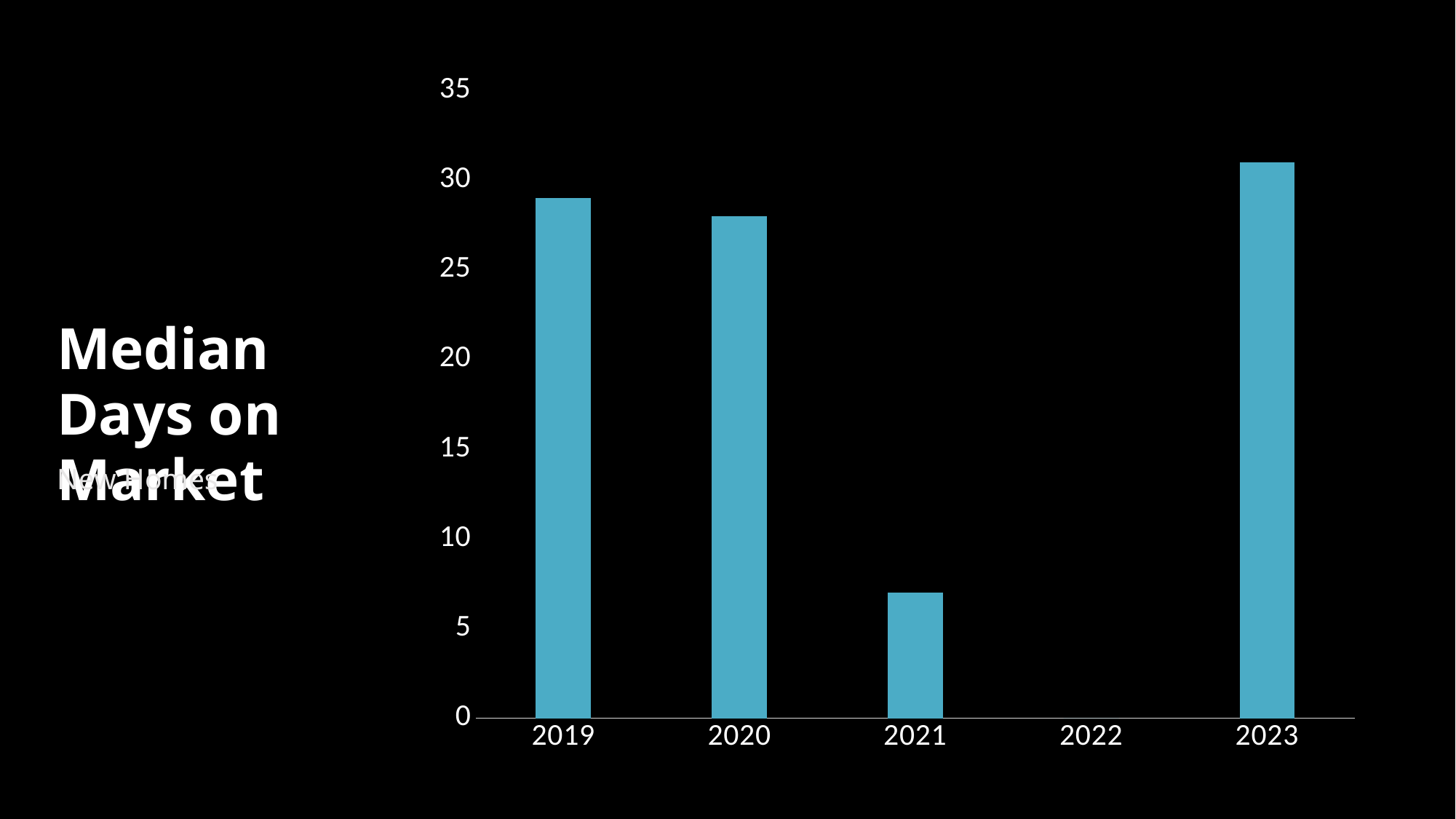
Is the value for 2023 greater or less than 30? greater Is the value for 2021 greater or less than 10? less How many years are shown on the x axis of the chart? 5 Do the values rise or fall from 2019 to 2021? fall Which year on the x axis has no bar shown? 2022 Is the value for 2019 greater or less than 25? greater Which year has the tallest bar in the chart? 2023 What is the title shown on the slide for the chart? Median Days on Market Which is larger, the value for 2023 or the value for 2019? 2023 Which year has the shortest visible bar in the chart? 2021 What kind of chart is shown on the slide? bar chart